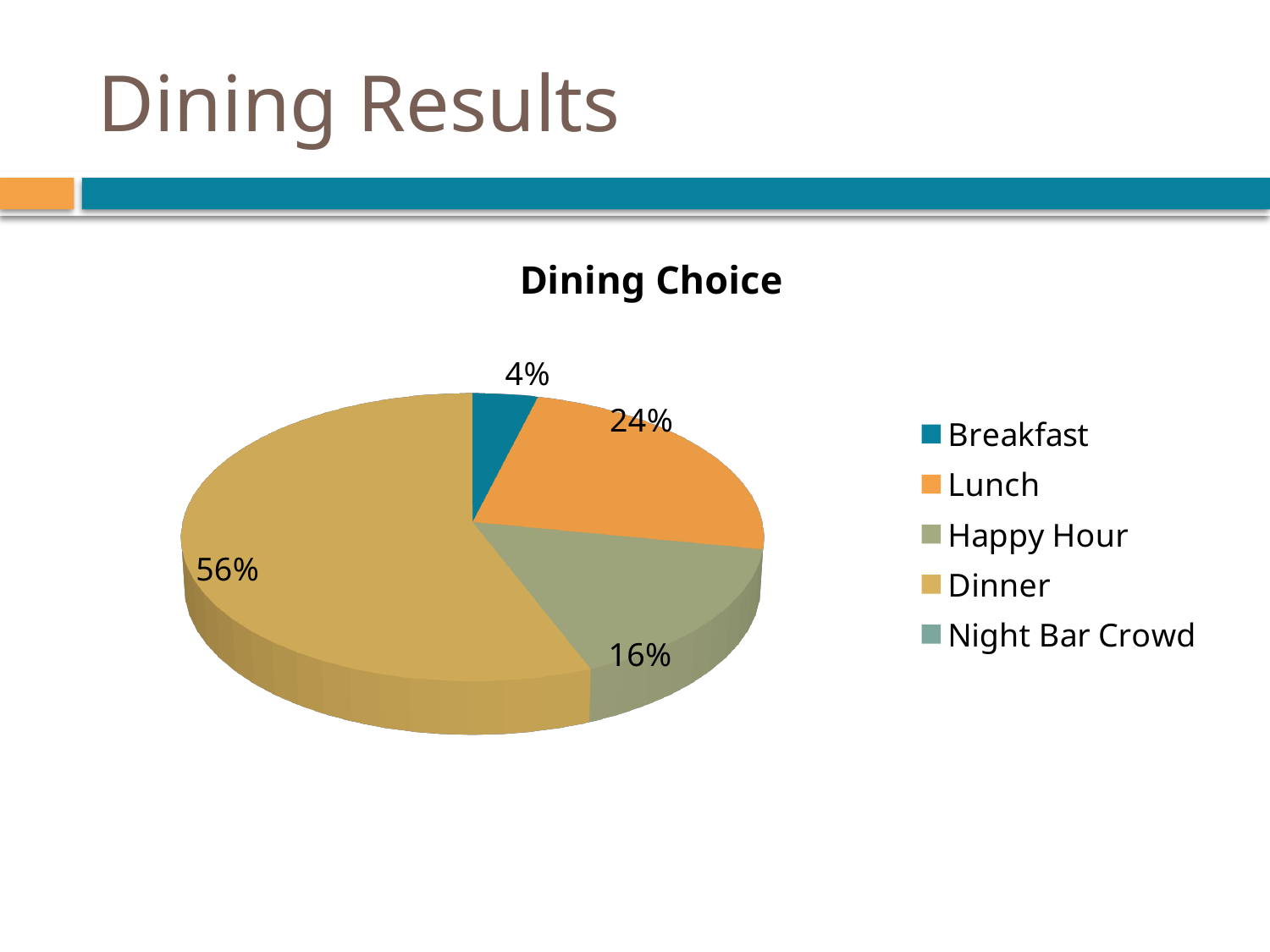
In the Dining Choice pie chart, what percentage is shown for Breakfast? 4% In the Dining Choice pie chart, which is larger, Lunch or Happy Hour? Lunch In the Dining Choice pie chart, how many percentage points larger is Dinner than Lunch? 32 percentage points In the Dining Choice pie chart, how many percentage points larger is Lunch than Happy Hour? 8 percentage points In the Dining Choice pie chart, what share of the pie does Happy Hour take? 16% In the Dining Choice pie chart, what percentage is shown for Lunch? 24% In the Dining Choice pie chart, which is larger, Breakfast or Happy Hour? Happy Hour What kind of chart is shown on the slide? Pie chart What is the title of the chart on the slide? Dining Choice How many categories does the legend of the Dining Choice chart list? 5 In the Dining Choice pie chart, what percentage is shown for Dinner? 56% Which category has the largest slice in the Dining Choice pie chart? Dinner